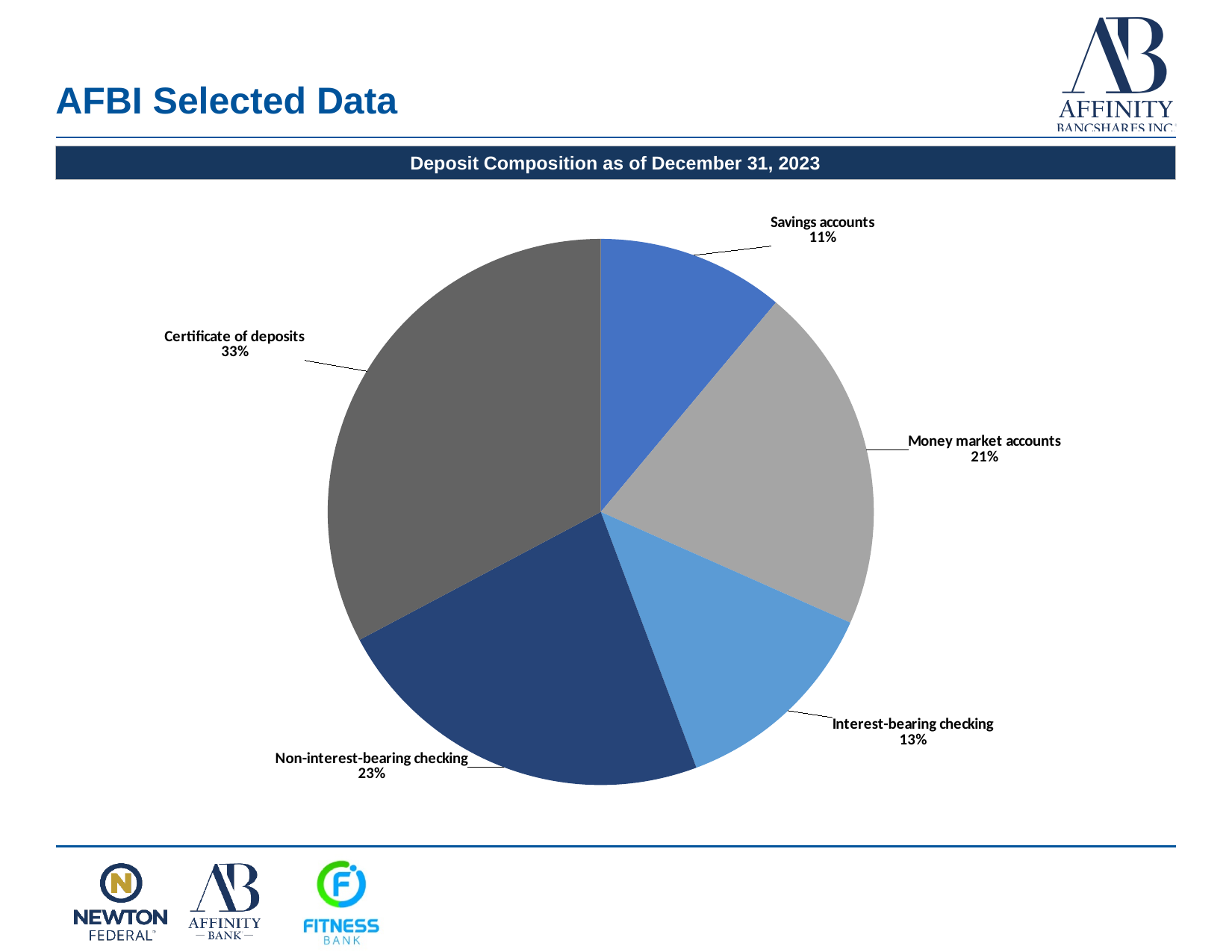
What share of deposits is Interest-bearing checking? 13% What is the title of the chart? Deposit Composition as of December 31, 2023 What share of deposits is Non-interest-bearing checking? 23% What is the difference in percentage points between Certificate of deposits and Non-interest-bearing checking? 10 Which is larger, Money market accounts or Interest-bearing checking? Money market accounts How many deposit categories are shown in the pie chart? 5 What share of deposits is Certificate of deposits? 33% Which deposit category has the smallest share? Savings accounts Which deposit category has the largest share? Certificate of deposits What kind of chart is shown on the slide? Pie chart